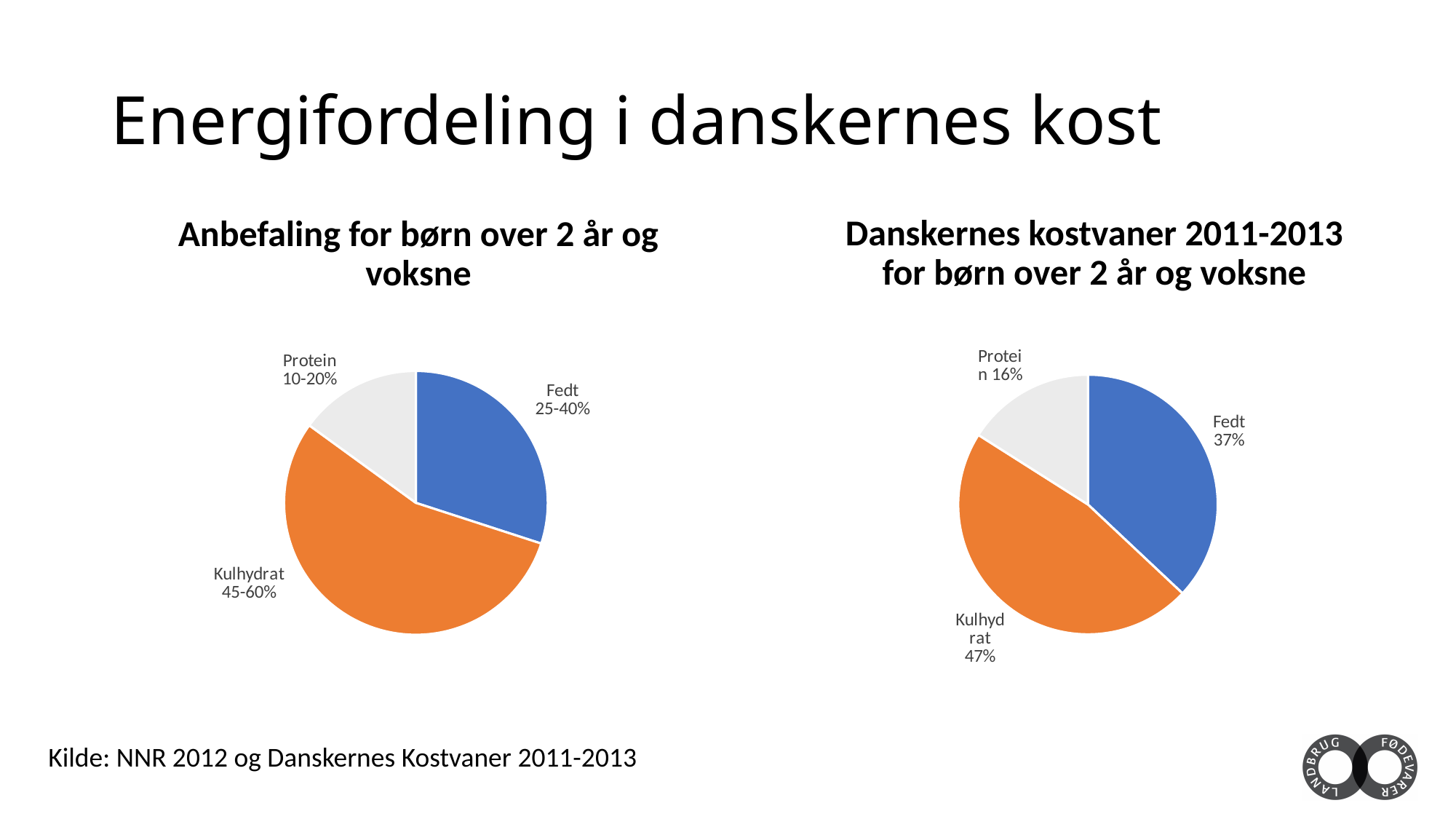
In the chart titled "Anbefaling for børn over 2 år og voksne", what range is shown for Protein? 10-20% In the chart titled "Danskernes kostvaner 2011-2013 for børn over 2 år og voksne", which category has the smallest share? Protein In the chart titled "Danskernes kostvaner 2011-2013 for børn over 2 år og voksne", how many percentage points larger is Kulhydrat than Fedt? 10 In the chart titled "Danskernes kostvaner 2011-2013 for børn over 2 år og voksne", what is the value for Protein? 16% In the chart titled "Danskernes kostvaner 2011-2013 for børn over 2 år og voksne", which category has the largest share? Kulhydrat In the chart titled "Danskernes kostvaner 2011-2013 for børn over 2 år og voksne", what is the value for Kulhydrat? 47% How many slices does the chart titled "Anbefaling for børn over 2 år og voksne" have? 3 What kind of chart is the chart on the right of the slide? Pie chart In the chart titled "Danskernes kostvaner 2011-2013 for børn over 2 år og voksne", what is the value for Fedt? 37% In the chart titled "Anbefaling for børn over 2 år og voksne", what range is shown for Kulhydrat? 45-60% In the chart titled "Anbefaling for børn over 2 år og voksne", what range is shown for Fedt? 25-40% In the chart titled "Danskernes kostvaner 2011-2013 for børn over 2 år og voksne", which is larger, Fedt or Protein? Fedt